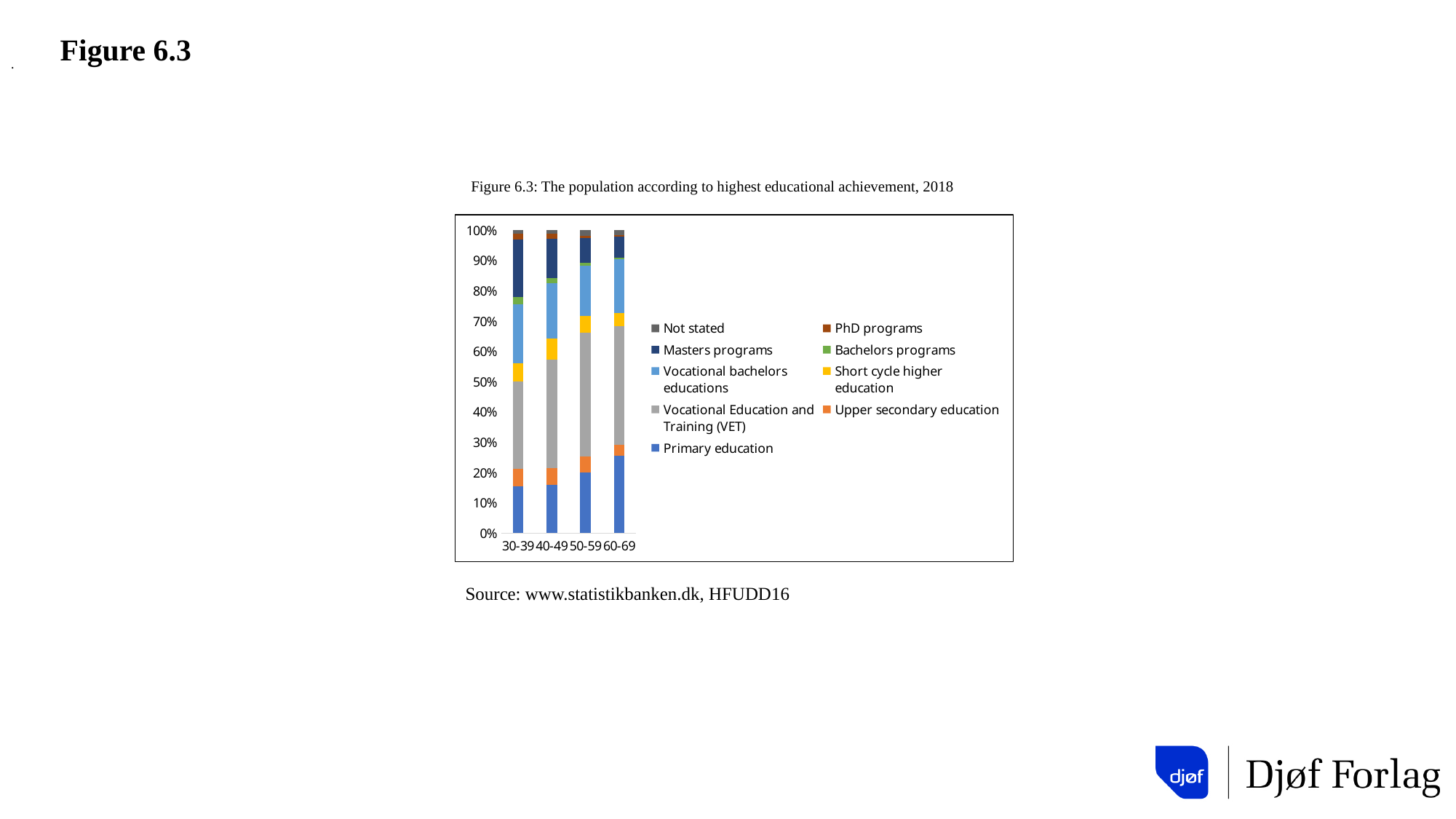
How many age groups are shown on the x axis of the chart? 4 Is the Primary education share for the 30-39 age group greater or less than 20%? less How many series does the chart's legend list? 9 Which age group has the largest Masters programs segment? 30-39 What kind of chart is shown on the slide? stacked bar chart Which legend entry is shown in yellow? Short cycle higher education What is the title of the chart? Figure 6.3: The population according to highest educational achievement, 2018 Is the Vocational Education and Training (VET) segment larger for the 60-69 group or the 30-39 group? 60-69 Does the Primary education share rise or fall from the 30-39 group to the 60-69 group? rise Is the Primary education share for the 60-69 age group greater or less than 20%? greater What is the total height of the stacked bar for the 40-49 age group? 100%